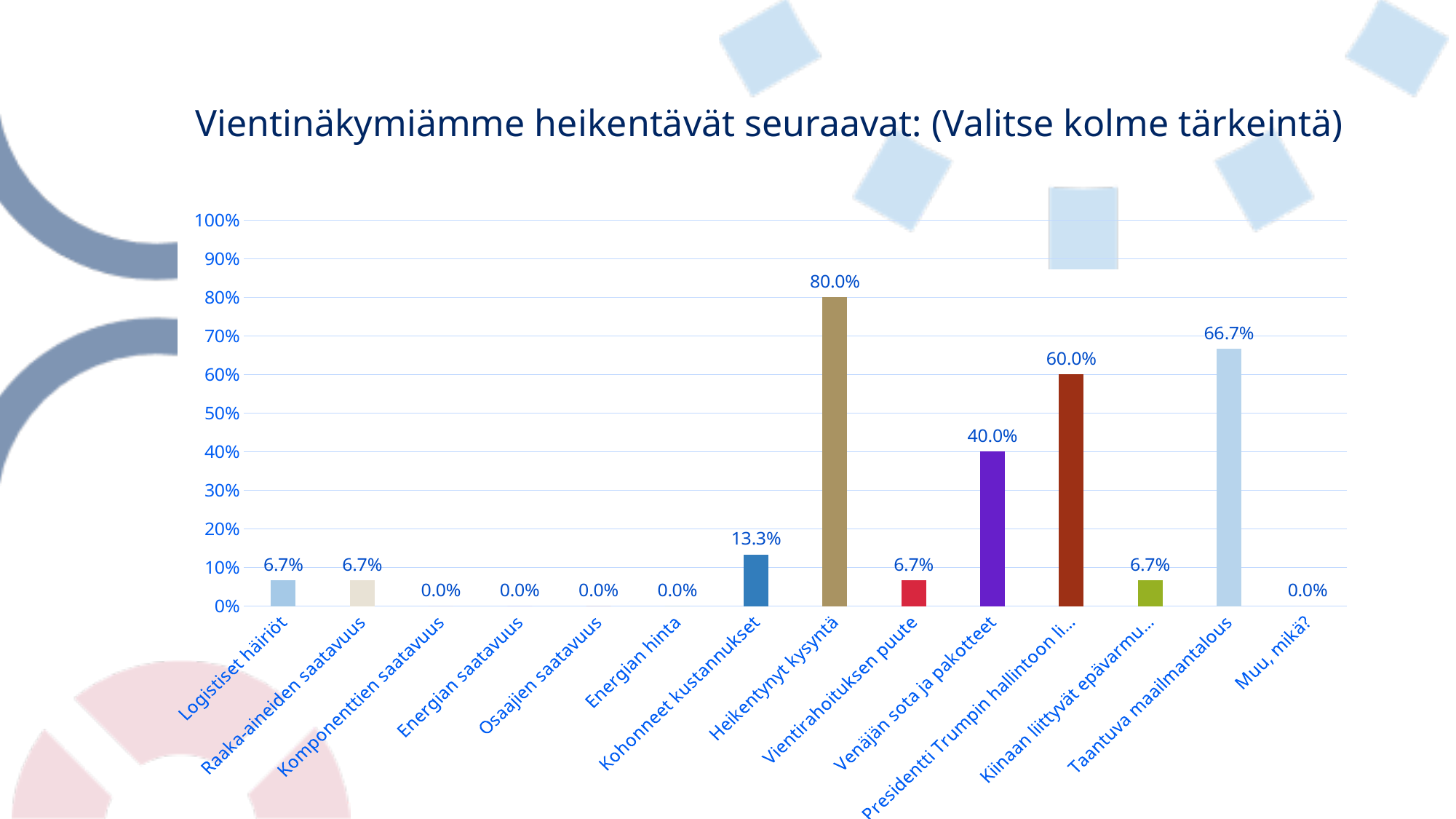
What is the value for Heikentynyt kysyntä? 80.0% Is the value for Heikentynyt kysyntä greater or less than 70%? greater What kind of chart is shown on the slide? bar chart What is the value for Kohonneet kustannukset? 13.3% What is the value for Energian hinta? 0.0% Which category has the highest value? Heikentynyt kysyntä How many categories are shown on the x axis? 14 Which is larger, the value for Venäjän sota ja pakotteet or the value for Taantuva maailmantalous? Taantuva maailmantalous What is the title of the chart? Vientinäkymiämme heikentävät seuraavat: (Valitse kolme tärkeintä) What is the value for Taantuva maailmantalous? 66.7% What is the value for Venäjän sota ja pakotteet? 40.0% What is the difference between the values for Heikentynyt kysyntä and Taantuva maailmantalous? 13.3%